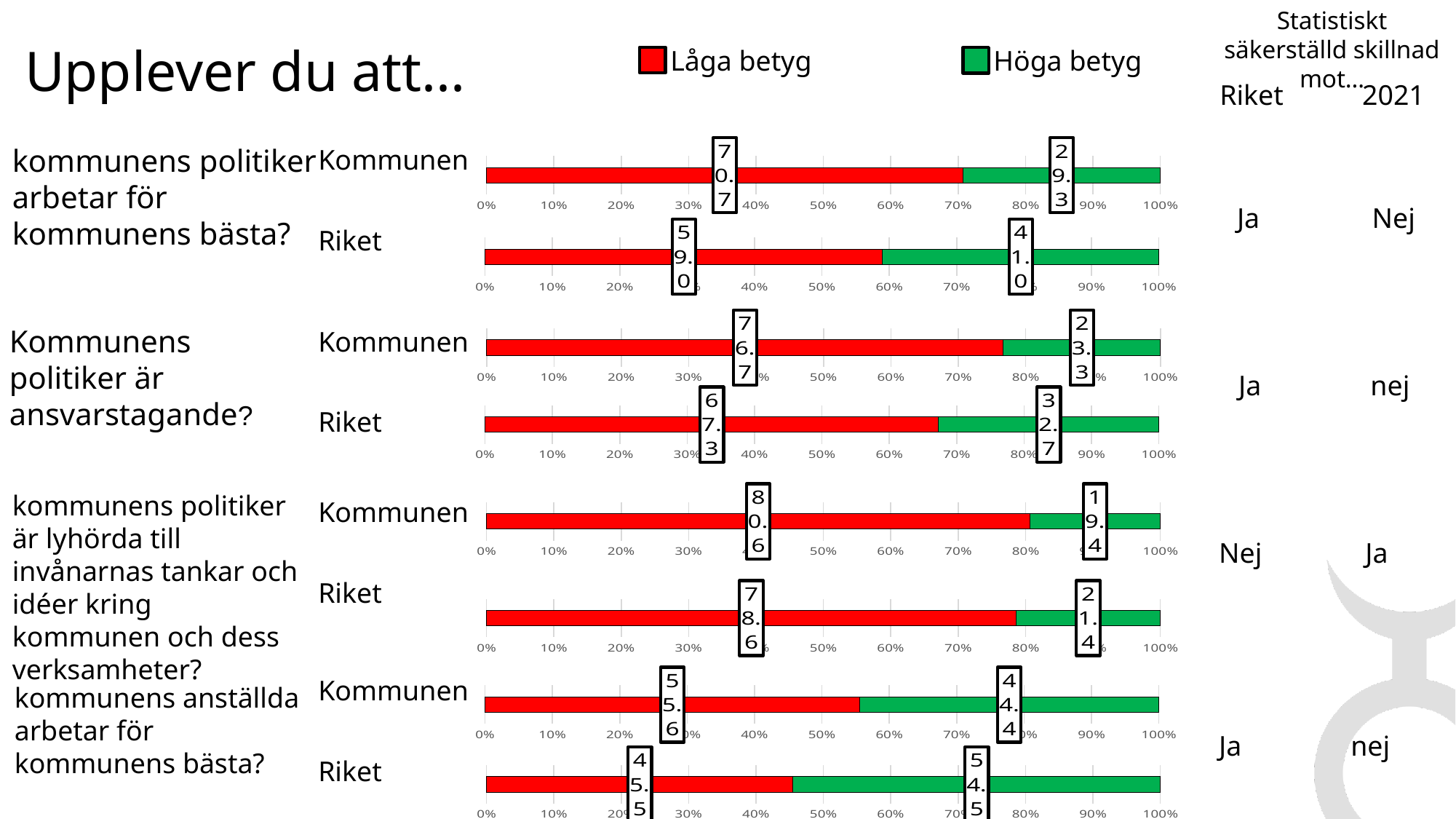
In the chart for 'Kommunens politiker är ansvarstagande?', what is the Låga betyg value for Kommunen? 76.7 In the chart for 'Kommunens politiker är ansvarstagande?', what is the Höga betyg value for Riket? 32.7 In the chart for 'kommunens politiker är lyhörda till invånarnas tankar och idéer...', what is the Höga betyg value for Kommunen? 19.4 Which colour represents Höga betyg in the legend? Green In the chart for 'kommunens politiker arbetar för kommunens bästa?', is the Låga betyg value for Riket greater or less than 50%? greater In the chart for 'kommunens politiker arbetar för kommunens bästa?', what is the Låga betyg value for Kommunen? 70.7 How many series does the legend list? 2 In the chart for 'kommunens politiker är lyhörda...', what is the difference between the Låga betyg values for Kommunen and Riket? 2.0 In the chart for 'kommunens politiker arbetar för kommunens bästa?', what is the Höga betyg value for Riket? 41.0 In the chart for 'kommunens anställda arbetar för kommunens bästa?', what is the Höga betyg value for Riket? 54.5 In the chart for 'kommunens anställda arbetar för kommunens bästa?', which is larger for Kommunen: Låga betyg or Höga betyg? Låga betyg What kind of chart is used for the Kommunen and Riket rows? Stacked bar chart